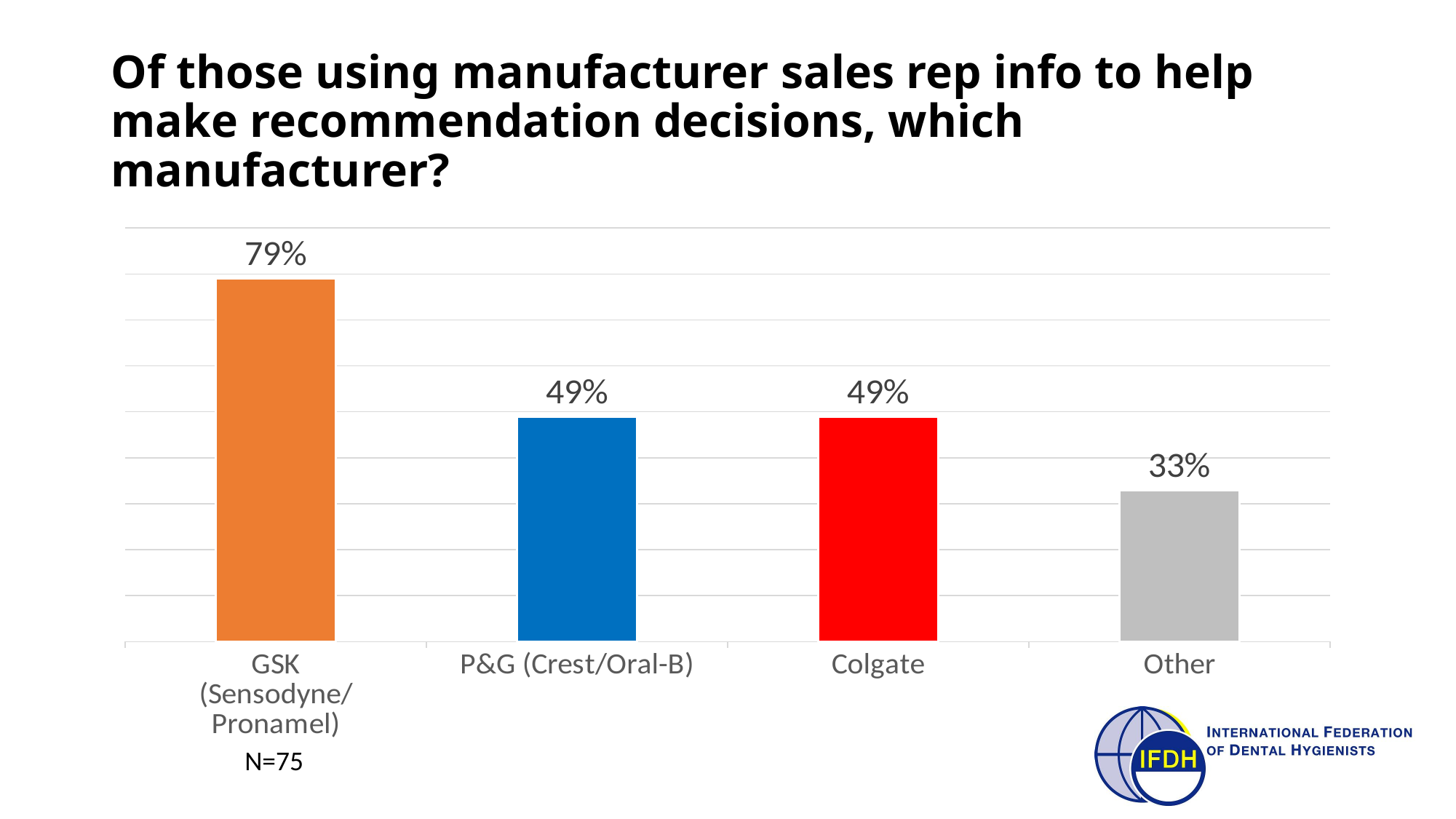
What percentage is shown for GSK (Sensodyne/Pronamel)? 79% Which manufacturer has the highest percentage? GSK (Sensodyne/Pronamel) What percentage is shown for Other? 33% What is the difference in percentage points between P&G (Crest/Oral-B) and Other? 16 Which category has the lowest percentage? Other What percentage is shown for Colgate? 49% What type of chart is shown on the slide? Bar chart What is the difference in percentage points between GSK (Sensodyne/Pronamel) and Colgate? 30 How many manufacturer categories are shown in the chart? 4 Which is larger, the value for GSK (Sensodyne/Pronamel) or the value for Other? GSK (Sensodyne/Pronamel) What sample size (N) is noted on the slide? N=75 What percentage is shown for P&G (Crest/Oral-B)? 49%